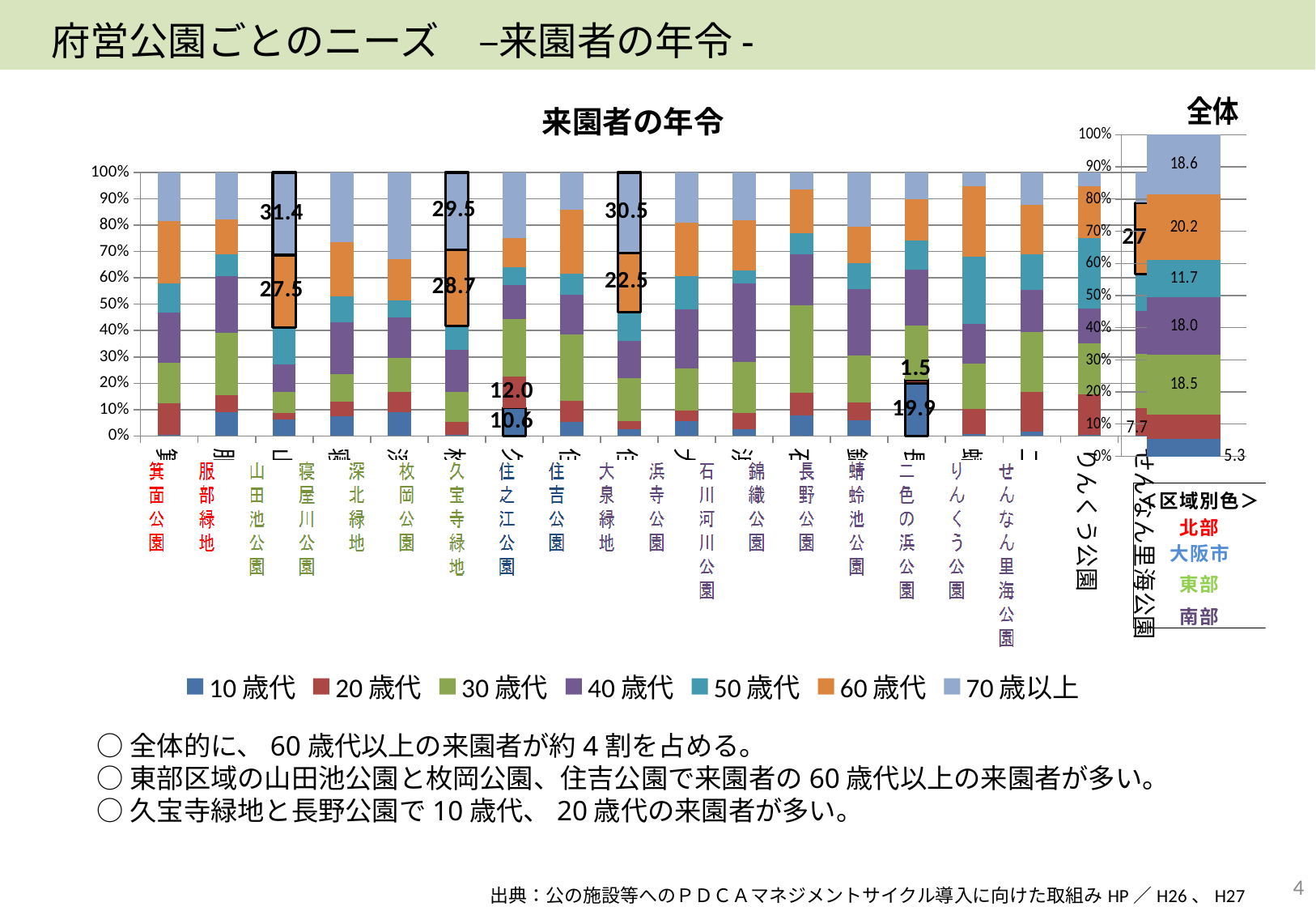
In the 全体 chart on the right, what is the value for 10歳代? 5.3 In the 全体 chart on the right, what is the difference between the 70歳以上 value and the 10歳代 value? 13.3 In the 全体 chart on the right, what is the combined value of 60歳代 and 70歳以上? 38.8 In the 全体 chart on the right, which age group has the smallest share? 10歳代 What kind of chart is the main chart titled 来園者の年令? Stacked bar chart What is the title of the main chart on the slide? 来園者の年令 In the 全体 chart on the right, what is the value for 60歳代? 20.2 How many series does the legend of the 来園者の年令 chart list? 7 In the 来園者の年令 chart, what is the labelled value for 70歳以上 at 山田池公園? 31.4 In the 全体 chart on the right, which age group has the largest share? 60歳代 In the 全体 chart on the right, which is larger, the value for 30歳代 or the value for 40歳代? 30歳代